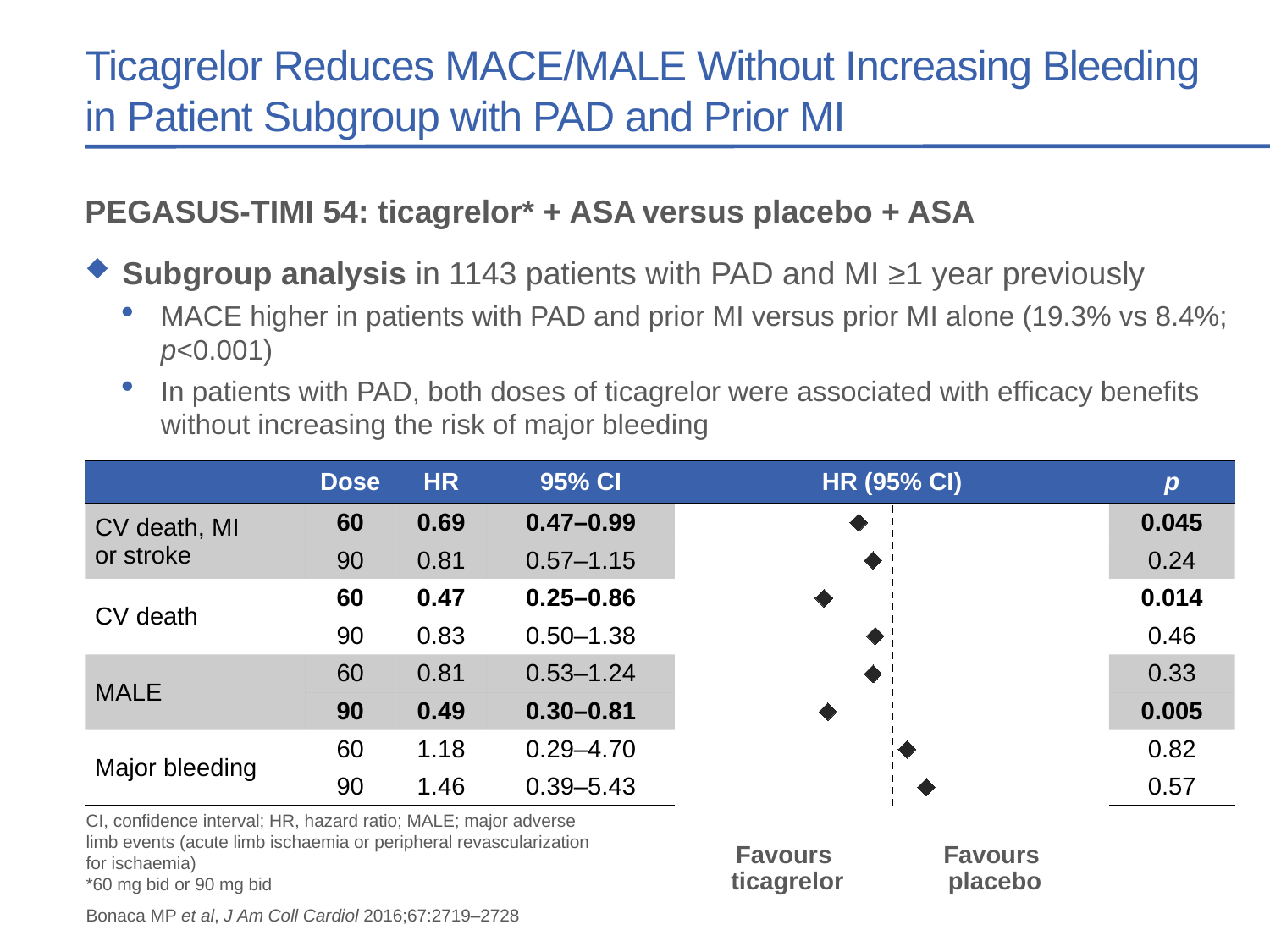
In the HR (95% CI) forest plot, is the hazard ratio for major bleeding at the 90 mg dose greater or less than 1? greater In the HR (95% CI) forest plot, what is the hazard ratio for CV death at the 60 mg dose? 0.47 What kind of chart is shown in the HR (95% CI) column of the table? Forest plot In the HR (95% CI) forest plot, is the hazard ratio for MALE larger at the 60 mg dose or the 90 mg dose? 60 mg What label appears under the left side of the HR (95% CI) forest plot? Favours ticagrelor In the HR (95% CI) forest plot, what is the difference between the hazard ratios for major bleeding at 90 mg and 60 mg? 0.28 In the HR (95% CI) forest plot, is the hazard ratio for CV death at the 60 mg dose greater or less than 1? less How many data points (diamonds) are plotted in the HR (95% CI) forest plot? 8 In the HR (95% CI) forest plot, what is the 95% CI for MALE at the 90 mg dose? 0.30–0.81 In the HR (95% CI) forest plot, which outcome and dose has the highest hazard ratio? Major bleeding, 90 mg In the HR (95% CI) forest plot, which outcome and dose has the lowest hazard ratio? CV death, 60 mg In the HR (95% CI) forest plot, what is the p value for CV death, MI or stroke at the 60 mg dose? 0.045